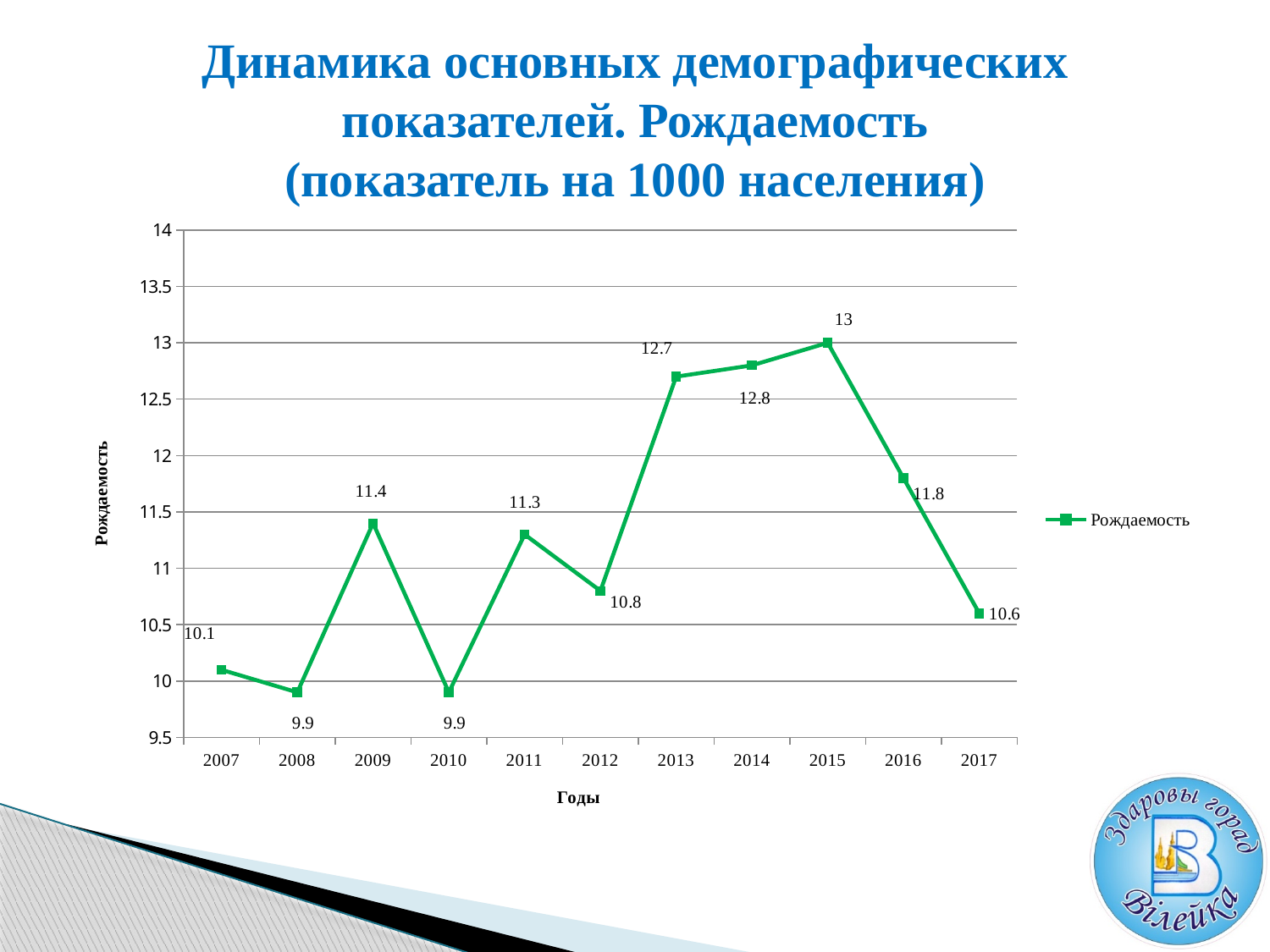
Which year has the highest birth rate? 2015 What is the label of the x axis? Годы What is the birth rate value for 2009? 11.4 What is the birth rate value for 2017? 10.6 How many years are plotted on the chart? 11 What is the difference between the birth rate in 2015 and in 2017? 2.4 Is the value for 2016 greater or less than 11.5? greater Which year has a higher birth rate, 2013 or 2014? 2014 What is the birth rate value for 2015? 13 How many series does the legend list? 1 What kind of chart is shown on the slide? line chart What is the lowest birth rate value shown on the chart? 9.9